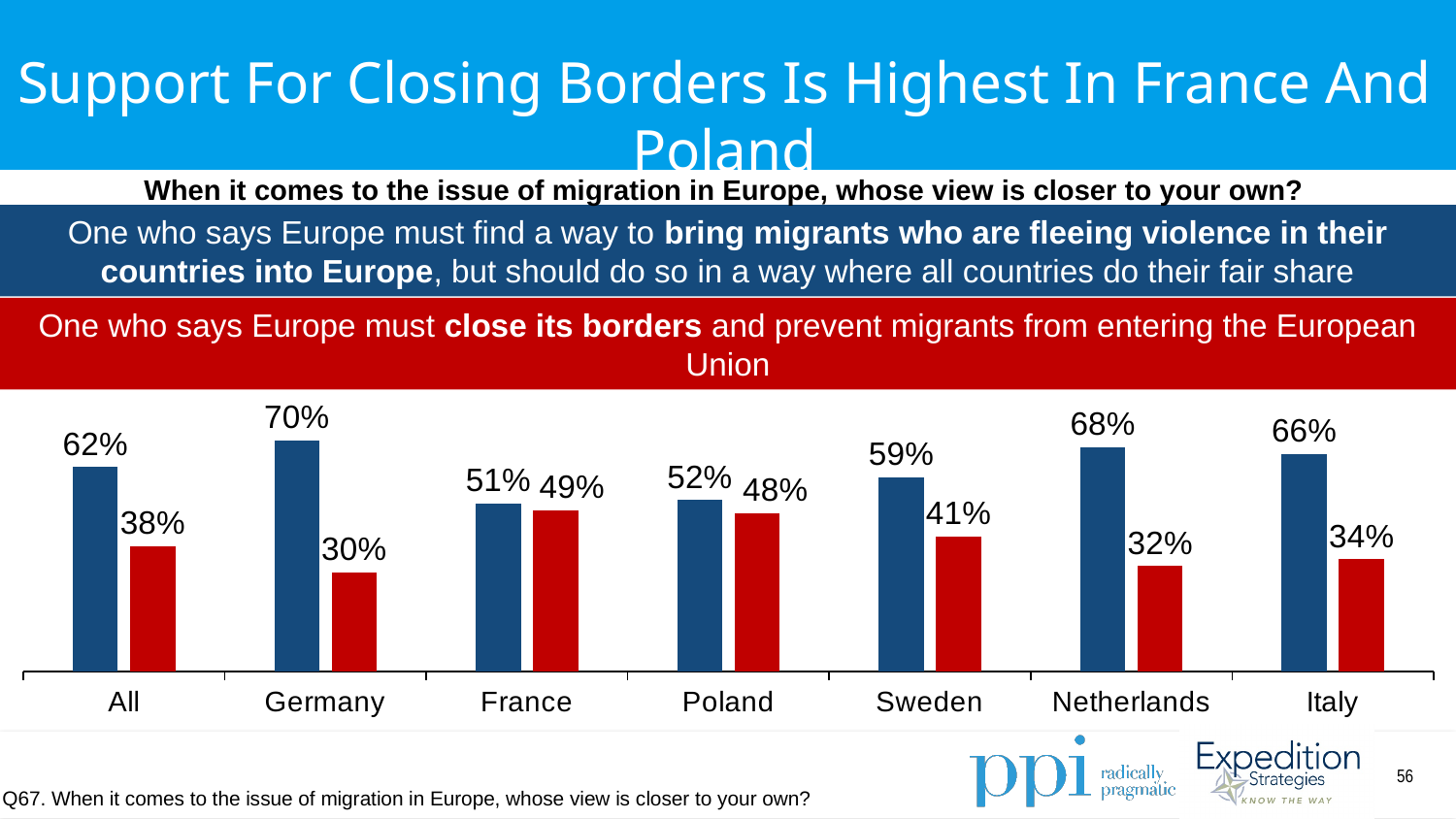
Which country has the lowest share saying Europe must close its borders? Germany How many countries or groups are shown on the x axis? 7 What percentage of respondents in Germany say Europe must bring migrants fleeing violence into Europe? 70% What type of chart is shown on the slide? Bar chart What colour are the bars representing the view that Europe must close its borders? Red How many series are plotted for each country? 2 What percentage of respondents in France say Europe must close its borders? 49% What is the difference between the two bars for Poland? 4 percentage points Which country has the highest share saying Europe must bring in migrants fleeing violence? Germany Which country has the highest share saying Europe must close its borders? France Is the 'bring migrants' value higher in Sweden or in Italy? Italy What is the value of the red (close its borders) bar for the Netherlands? 32%